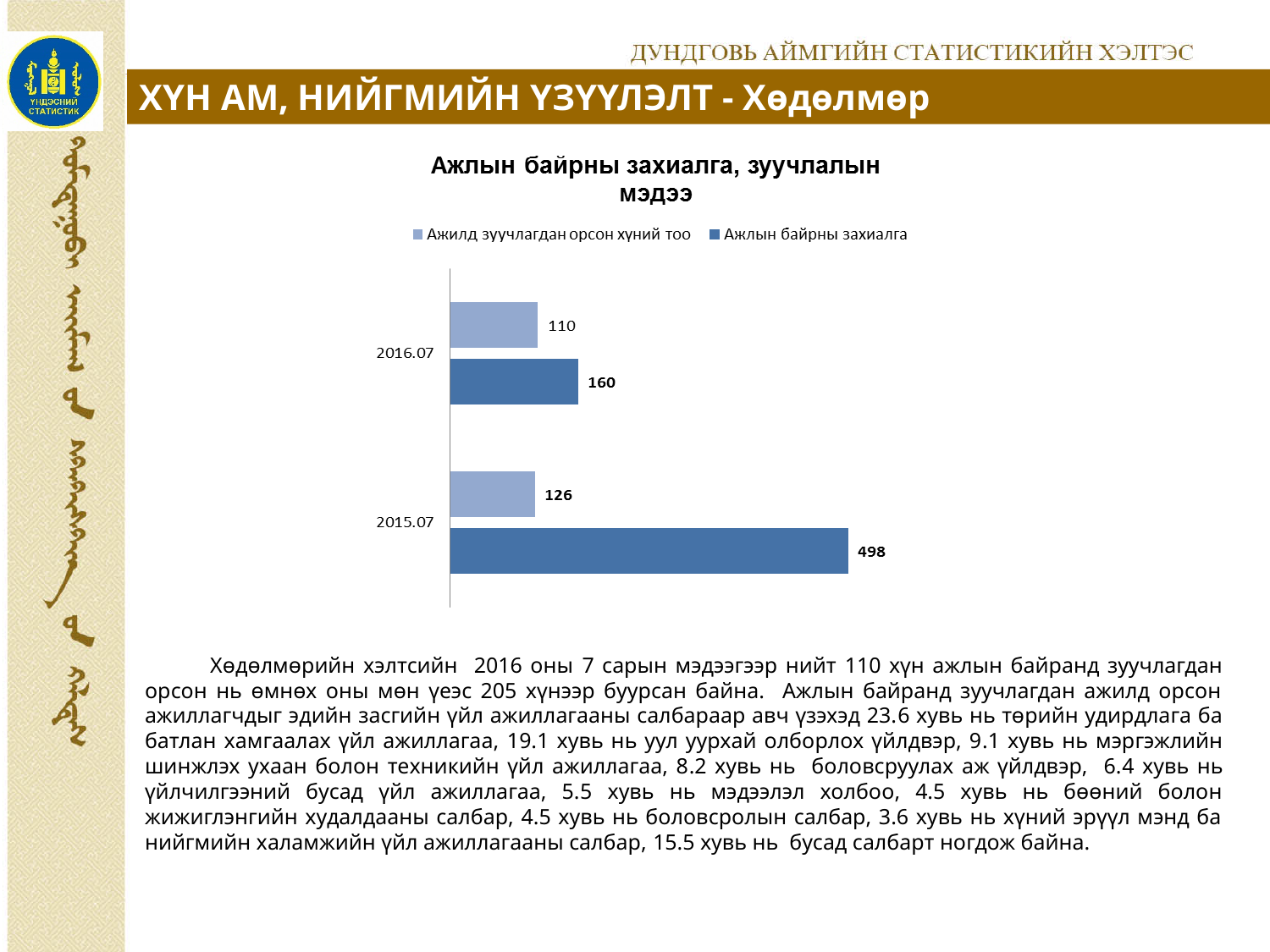
What is the difference between the "Ажилд зуучлагдан орсон хүний тоо" values for 2015.07 and 2016.07? 16 What kind of chart is shown on the slide? Bar chart What is the value of "Ажилд зуучлагдан орсон хүний тоо" for 2015.07? 126 What is the value of "Ажлын байрны захиалга" for 2016.07? 160 What is the difference between the "Ажлын байрны захиалга" values for 2015.07 and 2016.07? 338 How many series does the legend list? 2 Which category has the lowest value for "Ажилд зуучлагдан орсон хүний тоо"? 2016.07 Which category has the highest value for "Ажлын байрны захиалга"? 2015.07 What is the value of "Ажлын байрны захиалга" for 2015.07? 498 What is the value of "Ажилд зуучлагдан орсон хүний тоо" for 2016.07? 110 How many categories are shown on the chart? 2 Which is larger for 2016.07: "Ажилд зуучлагдан орсон хүний тоо" or "Ажлын байрны захиалга"? Ажлын байрны захиалга